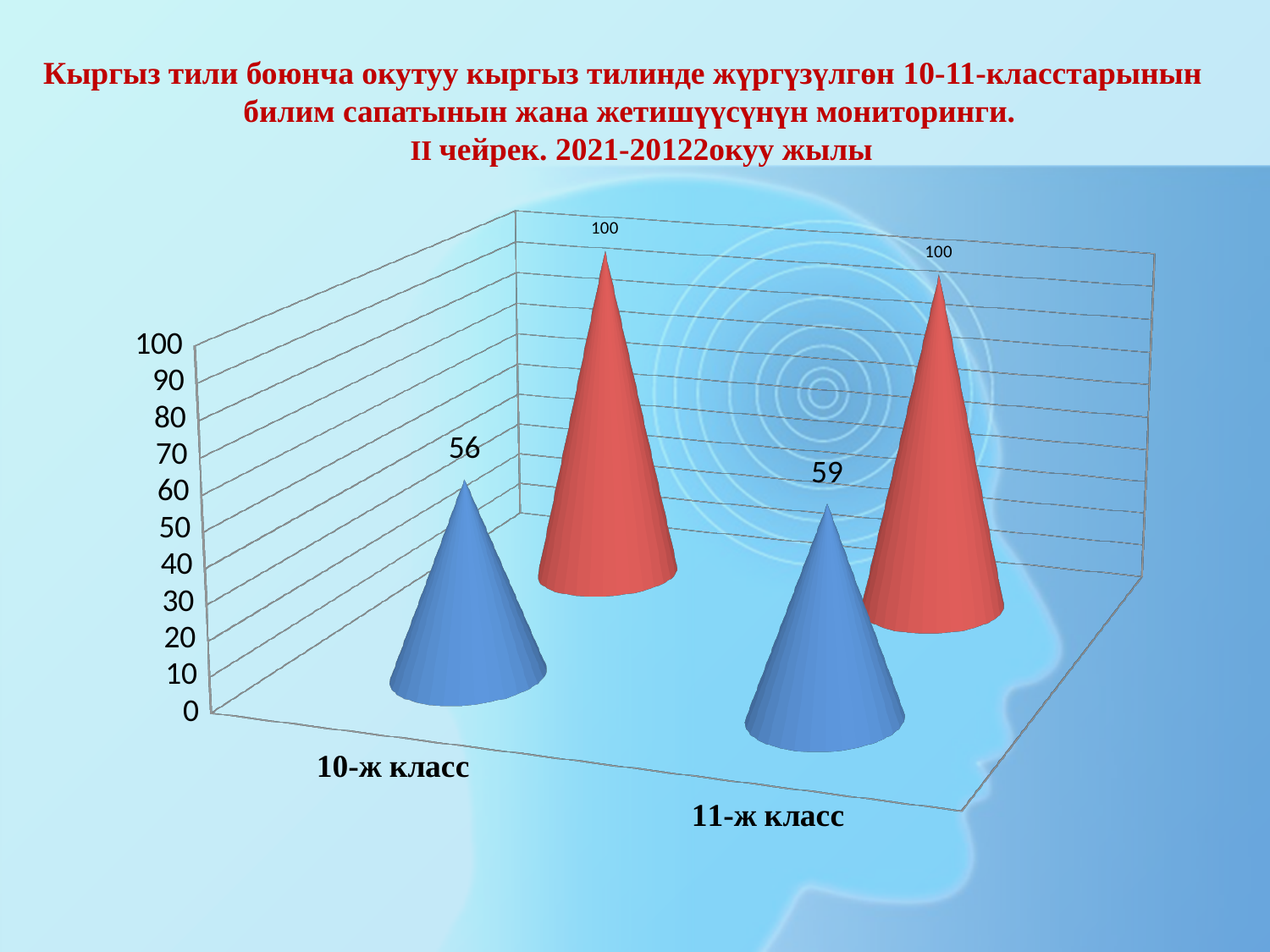
Which class has the lowest blue value? 10-ж класс What two colours are used for the cones in the chart? blue and red Is the blue value for 10-ж класс greater or less than 50? greater What is the value of the red cone for 10-ж класс? 100 How many classes (categories) are shown on the x axis? 2 What is the value of the red cone for 11-ж класс? 100 Which class has the larger blue value, 10-ж класс or 11-ж класс? 11-ж класс Which class has the highest blue value? 11-ж класс What is the difference between the blue values for 11-ж класс and 10-ж класс? 3 What is the value of the blue cone for 10-ж класс? 56 What is the value of the blue cone for 11-ж класс? 59 What kind of chart is shown on the slide? bar chart